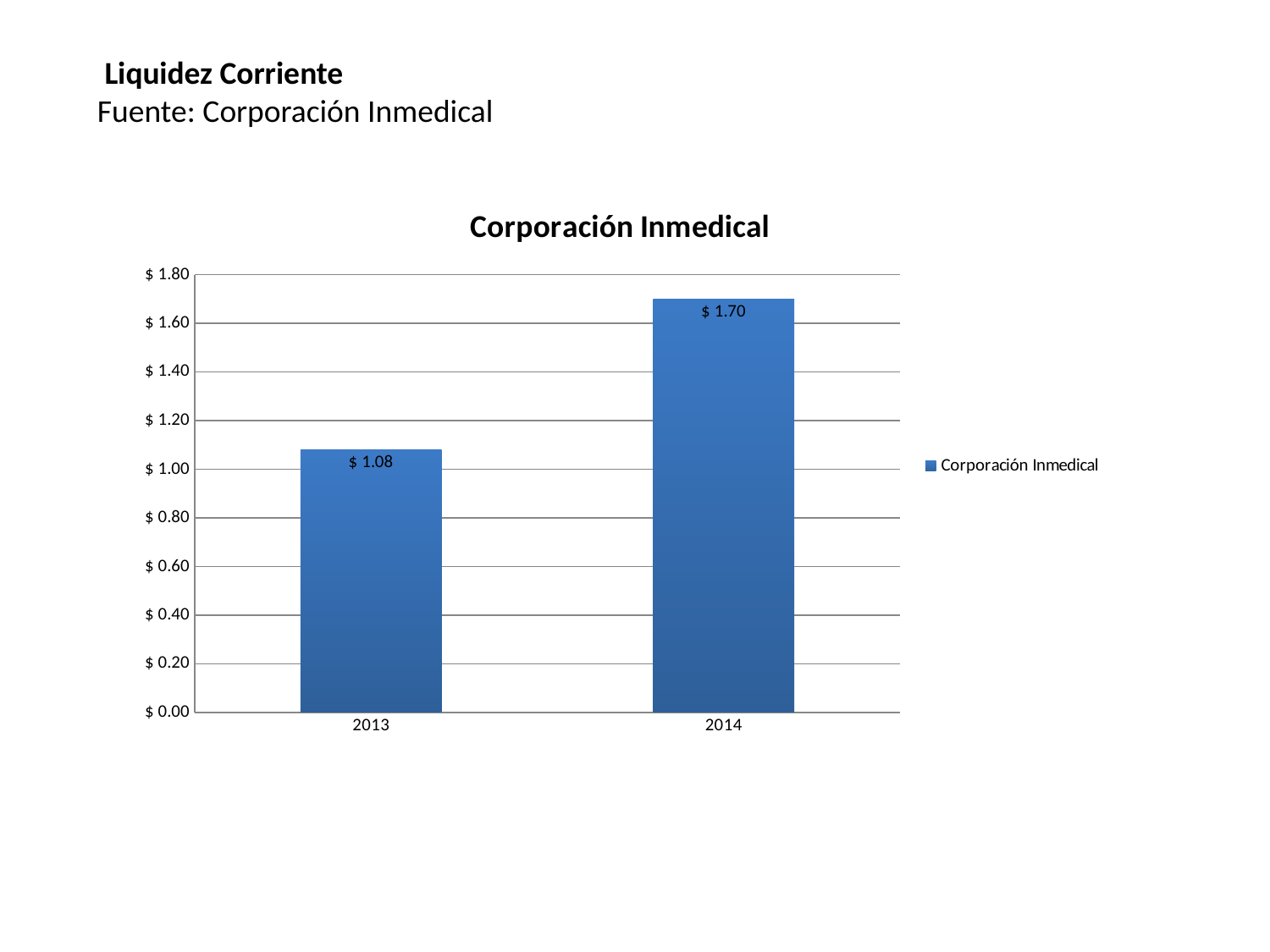
What is the value for 2013? $ 1.08 Which is larger, the value for 2013 or the value for 2014? 2014 What is the value for 2014? $ 1.70 Is the value for 2014 greater or less than $ 1.60? greater What is the difference between the values for 2014 and 2013? $ 0.62 How many series does the legend list? 1 Do the values rise or fall from 2013 to 2014? rise Which year has the highest value? 2014 What kind of chart is shown? bar chart Which year has the lowest value? 2013 Is the value for 2013 greater or less than $ 1.20? less How many years are shown on the x axis? 2